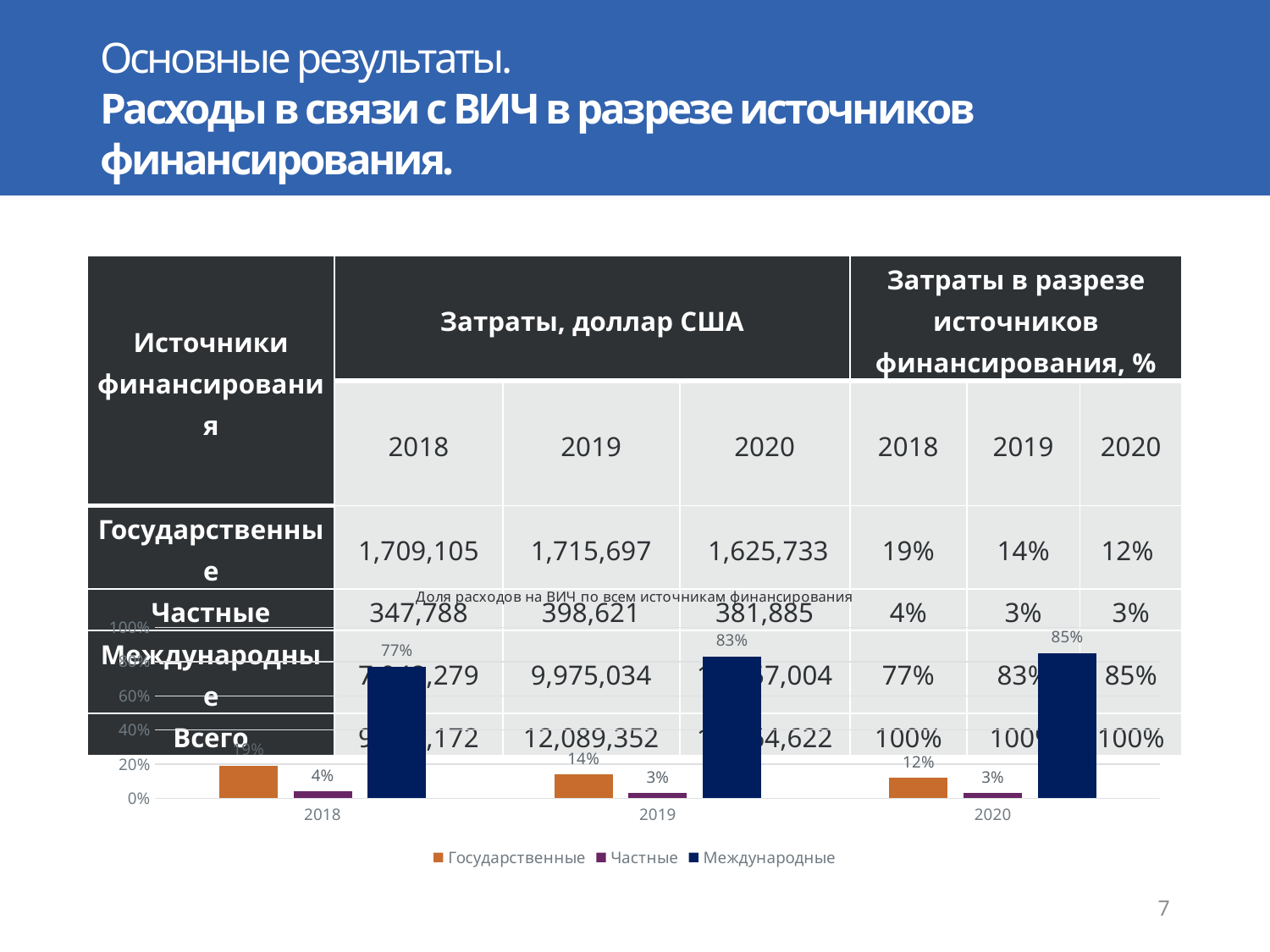
What kind of chart is shown on the slide? bar chart Does the Международные share rise or fall from 2018 to 2020 in the chart? rise Which series is shown in dark blue in the chart legend? Международные How many series does the chart legend list? 3 In which year is the Международные share highest in the chart? 2020 What is the value for Международные in 2020 in the chart? 85% What is the value for Международные in 2018 in the chart? 77% What is the value for Частные in 2018 in the chart? 4% What is the title of the chart? Доля расходов на ВИЧ по всем источникам финансирования How many years are shown on the x axis of the chart? 3 What is the value for Государственные in 2019 in the chart? 14% What is the difference between the Международные share in 2020 and in 2018? 8%